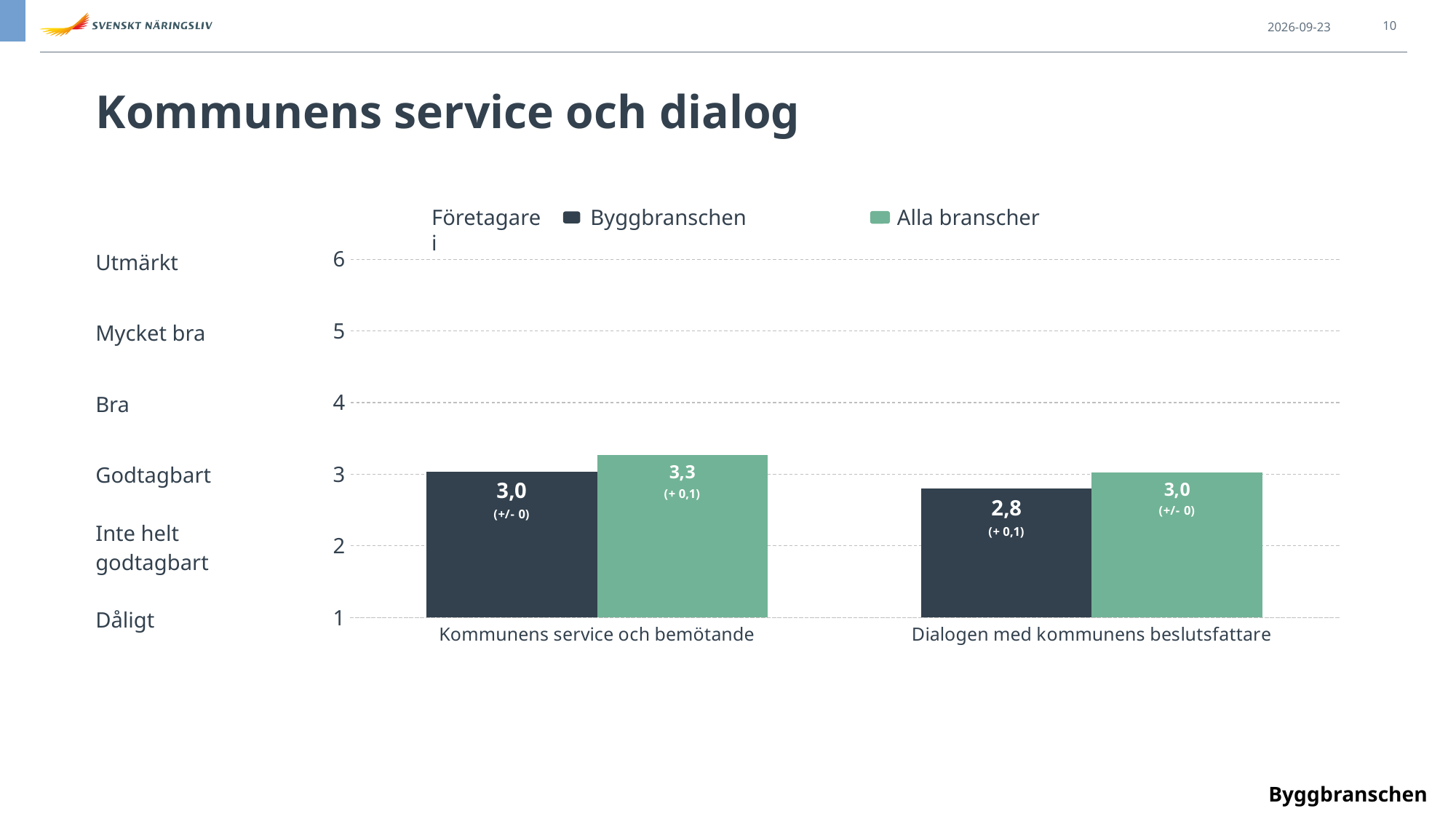
What is the value for Alla branscher in the category Dialogen med kommunens beslutsfattare? 3,0 How many categories are shown on the x axis of the chart? 2 Which is larger in the category Dialogen med kommunens beslutsfattare: Byggbranschen or Alla branscher? Alla branscher How many series does the chart's legend list with a colour marker? 2 What is the value for Byggbranschen in the category Kommunens service och bemötande? 3,0 What is the difference between Alla branscher and Byggbranschen in the category Kommunens service och bemötande? 0,3 What is the value for Alla branscher in the category Kommunens service och bemötande? 3,3 What change is shown in parentheses under the Byggbranschen value for Dialogen med kommunens beslutsfattare? (+ 0,1) Which bar has the lowest value in the chart? Byggbranschen, Dialogen med kommunens beslutsfattare What kind of chart is shown on the slide? Bar chart What is the value for Byggbranschen in the category Dialogen med kommunens beslutsfattare? 2,8 Which bar has the highest value in the chart? Alla branscher, Kommunens service och bemötande